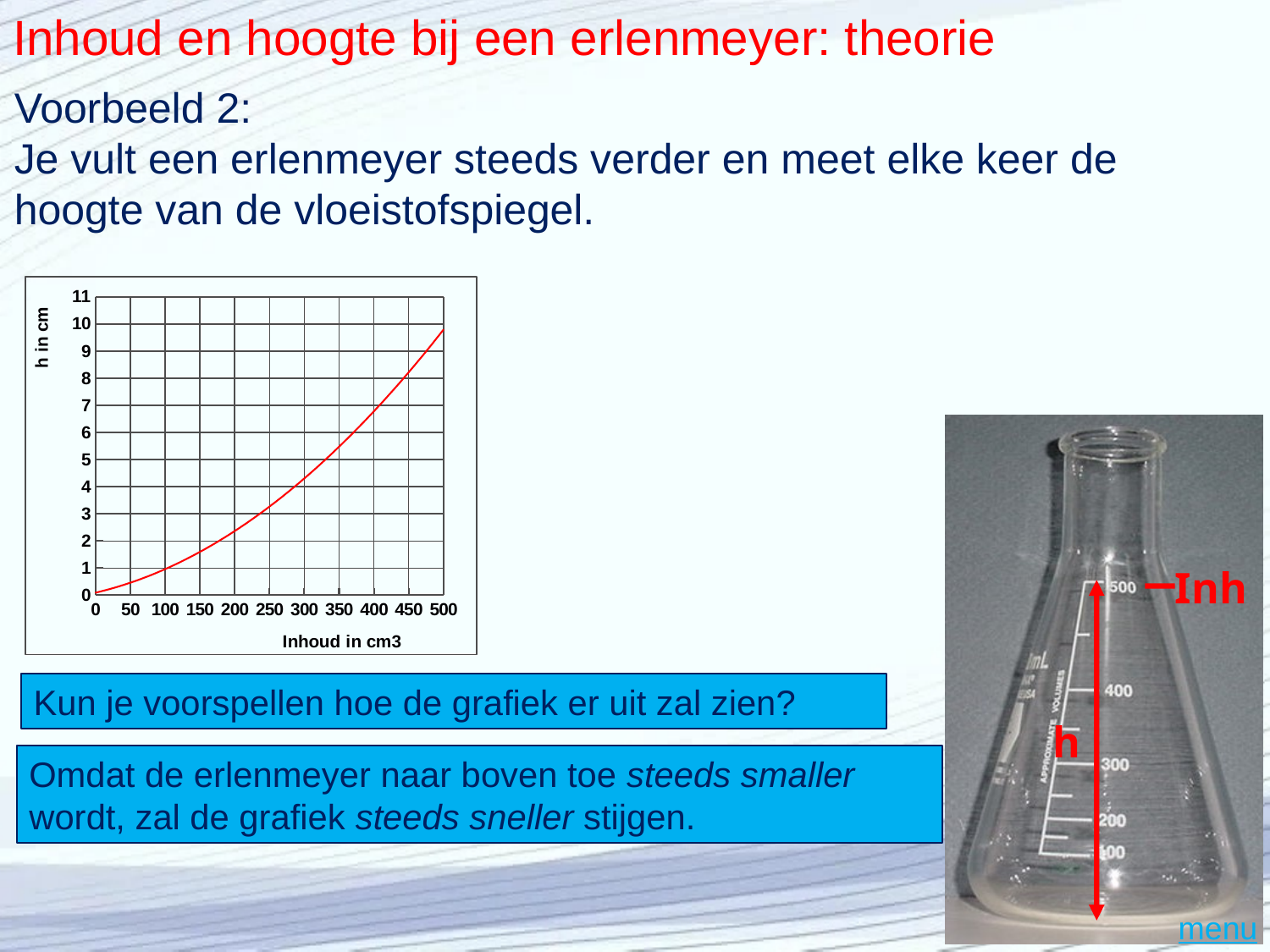
Is the value of h at Inhoud 300 cm3 greater or less than 5? less Is the value of h at Inhoud 200 cm3 greater or less than 3? less What is the highest value shown on the vertical axis of the chart? 11 Is the value of h at Inhoud 100 cm3 greater or less than 2? less What is the value of h when Inhoud is 0 cm3? 0 Does the value of h rise or fall as Inhoud increases along the x axis? rise What kind of chart is shown on the slide? line chart Which has the larger h value: Inhoud 200 cm3 or Inhoud 400 cm3? Inhoud 400 cm3 What is the label of the vertical axis of the chart? h in cm What is the label of the horizontal axis of the chart? Inhoud in cm3